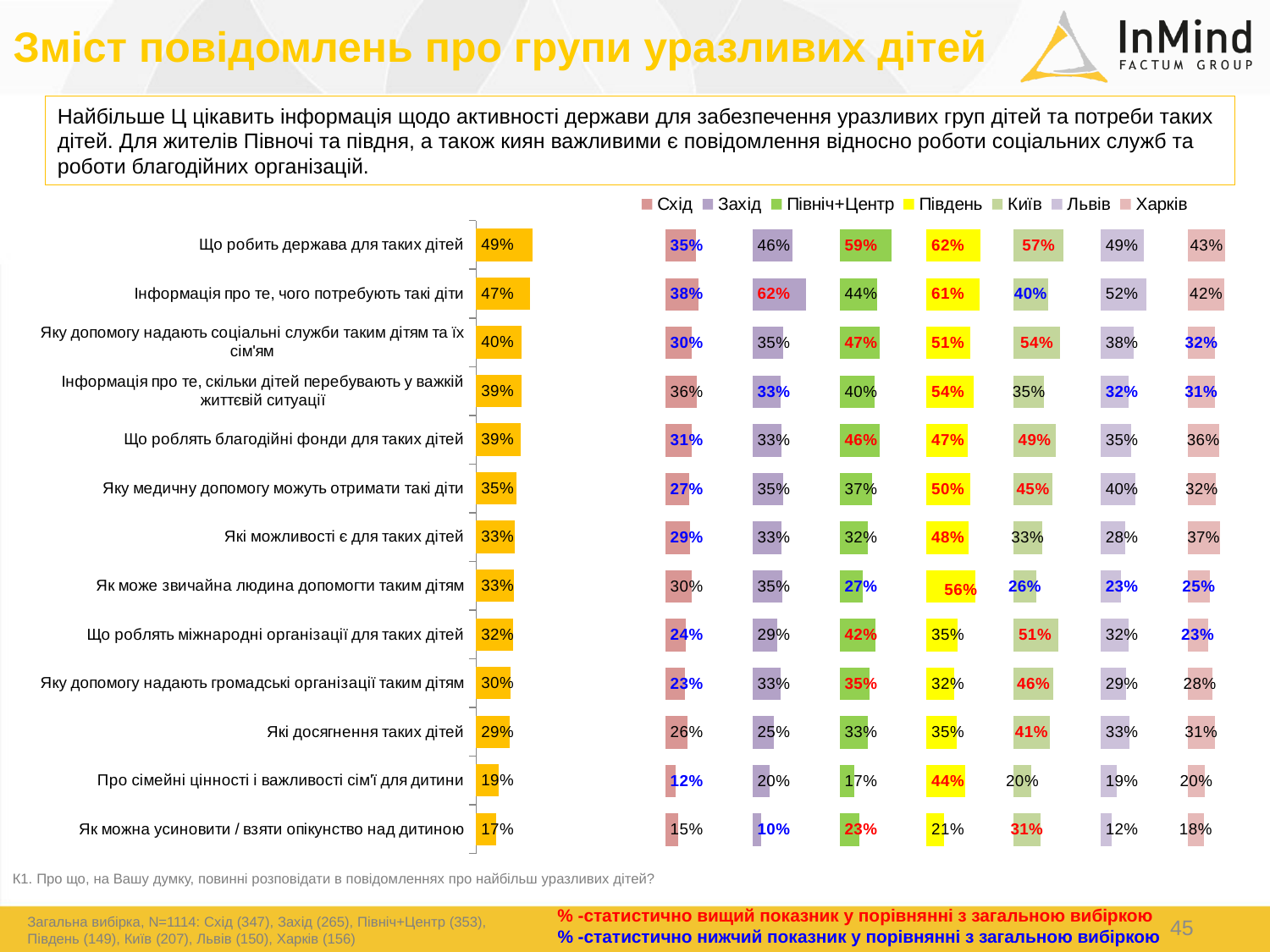
What is the difference between the overall values for "Що робить держава для таких дітей" (49%) and "Як можна усиновити / взяти опікунство над дитиною" (17%)? 32 percentage points What is the overall sample value for "Що робить держава для таких дітей"? 49% What is the value for Київ for "Яку допомогу надають соціальні служби таким дітям та їх сім'ям"? 54% For "Інформація про те, чого потребують такі діти", which is larger: the value for Захід or for Схід? Захід What is the value for Південь for "Що робить держава для таких дітей"? 62% How many regional series does the legend list? 7 How many categories (message topics) are shown on the chart? 13 What kind of chart shows the overall sample values on the left? Bar chart Which category has the highest overall sample value? Що робить держава для таких дітей What is the value for Схід for "Про сімейні цінності і важливості сім'ї для дитини"? 12% What colour represents Південь in the legend? Yellow Which category has the lowest overall sample value? Як можна усиновити / взяти опікунство над дитиною